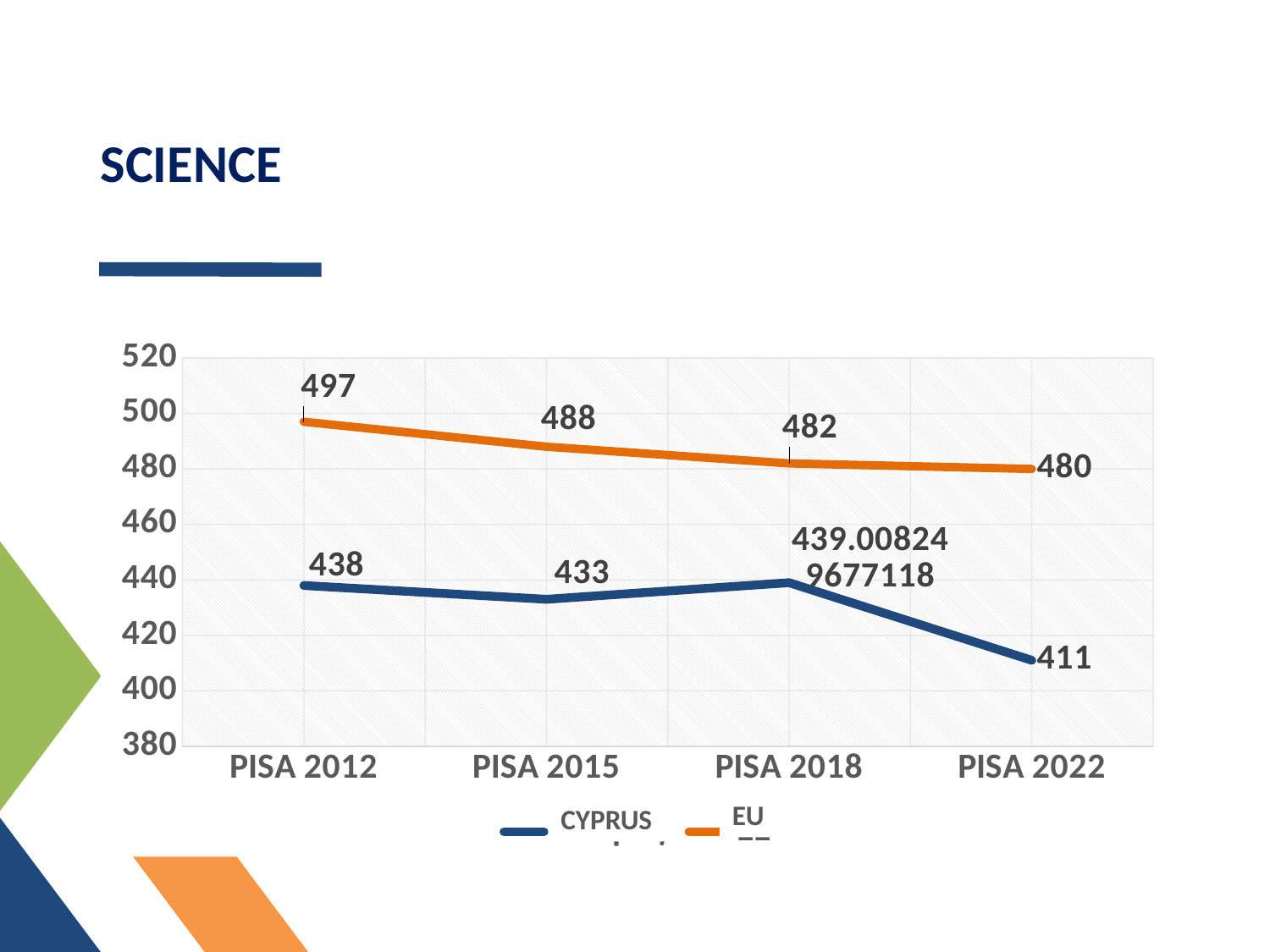
What is the difference between the EU and CYPRUS values for PISA 2022? 69 How many PISA rounds are shown on the x axis? 4 Which series has the larger value for PISA 2015, CYPRUS or EU? EU How many series does the legend list? 2 What is the CYPRUS value for PISA 2022? 411 In which PISA round is the CYPRUS value lowest? PISA 2022 In which PISA round is the EU value highest? PISA 2012 What kind of chart is shown on the slide? Line chart What is the CYPRUS value for PISA 2015? 433 What is the EU value for PISA 2018? 482 What is the difference between the EU values for PISA 2012 and PISA 2015? 9 What is the EU value for PISA 2012? 497